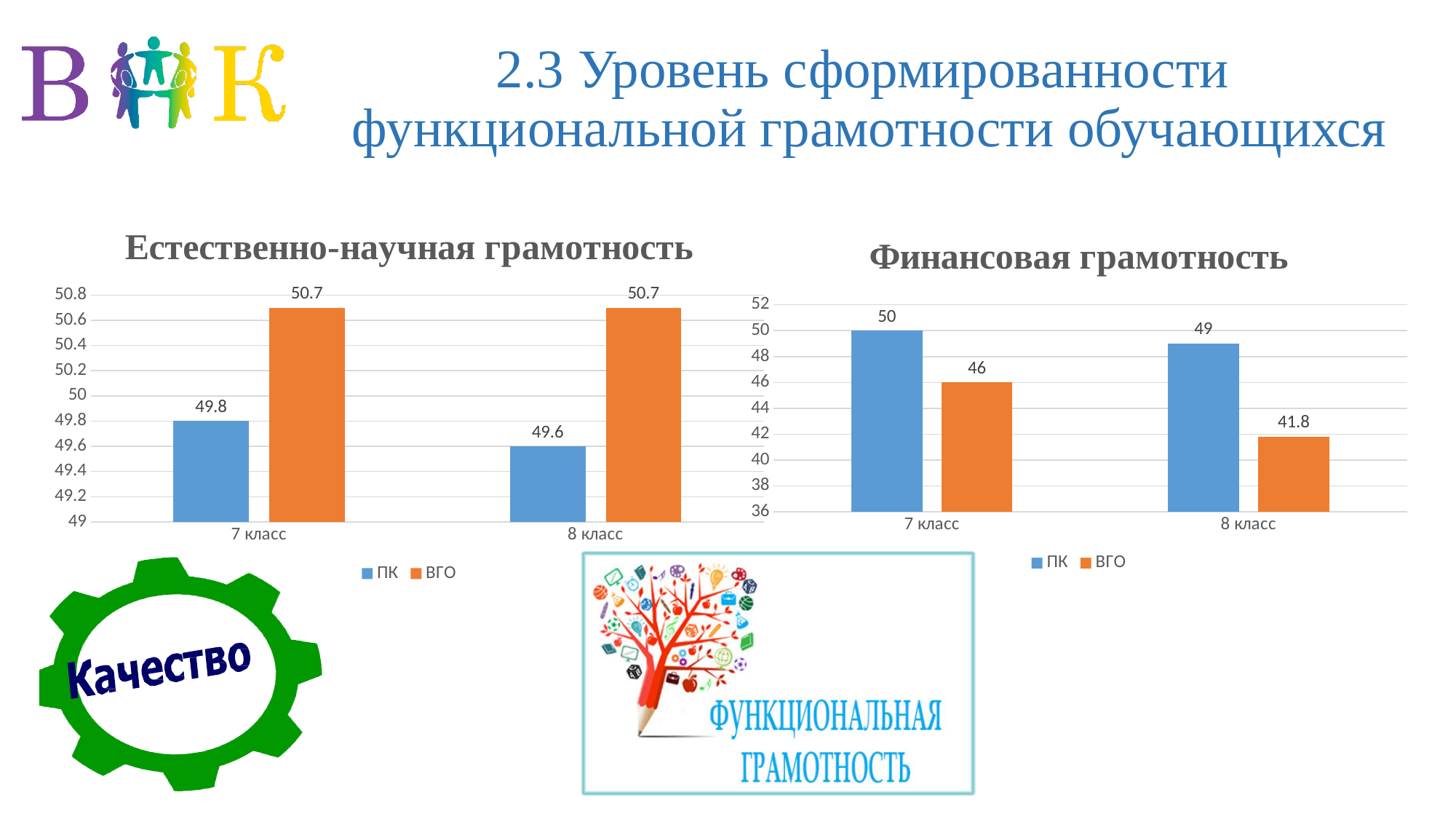
In the 'Естественно-научная грамотность' chart, what is the value of ПК for 7 класс? 49.8 In the 'Финансовая грамотность' chart, what is the difference between ПК and ВГО for 8 класс? 7.2 How many series does the legend of the 'Финансовая грамотность' chart list? 2 In the 'Финансовая грамотность' chart, what is the value of ПК for 7 класс? 50 In the 'Финансовая грамотность' chart, what is the value of ВГО for 8 класс? 41.8 In the 'Финансовая грамотность' chart, which series has the lowest value overall? ВГО (8 класс) What type of chart is the 'Естественно-научная грамотность' chart? Bar chart In the 'Естественно-научная грамотность' chart, what is the value of ВГО for 8 класс? 50.7 In the 'Финансовая грамотность' chart, does the ВГО value rise or fall from 7 класс to 8 класс? Fall In the 'Естественно-научная грамотность' chart, which is larger for 8 класс: ПК or ВГО? ВГО In the 'Финансовая грамотность' chart, which is larger for 7 класс: ПК or ВГО? ПК In the 'Естественно-научная грамотность' chart, what is the difference between ВГО and ПК for 7 класс? 0.9